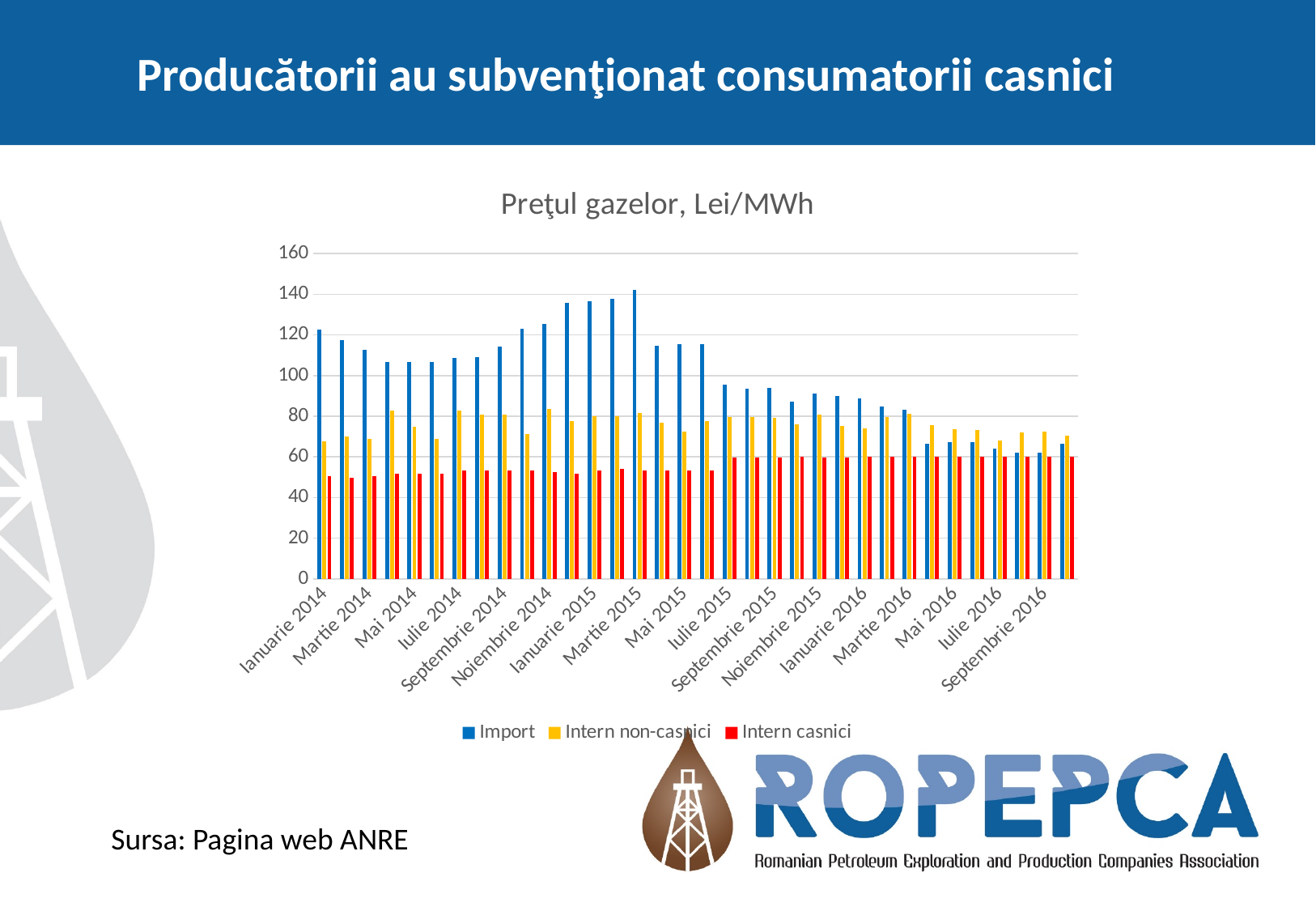
In Ianuarie 2014, which is larger: the Import value or the Intern casnici value? Import Is the Import value for Martie 2015 greater or less than 120? greater Which colour represents the Import series in the chart? blue What is the title of the chart? Preţul gazelor, Lei/MWh Is the Intern casnici value for Ianuarie 2014 greater or less than 60? less How many series does the legend list? 3 What kind of chart is shown on the slide? bar chart Is the Import value for Iulie 2015 greater or less than 80? greater In which month is the Import value highest? Martie 2015 Does the Import series rise or fall from Martie 2015 to Septembrie 2016? fall